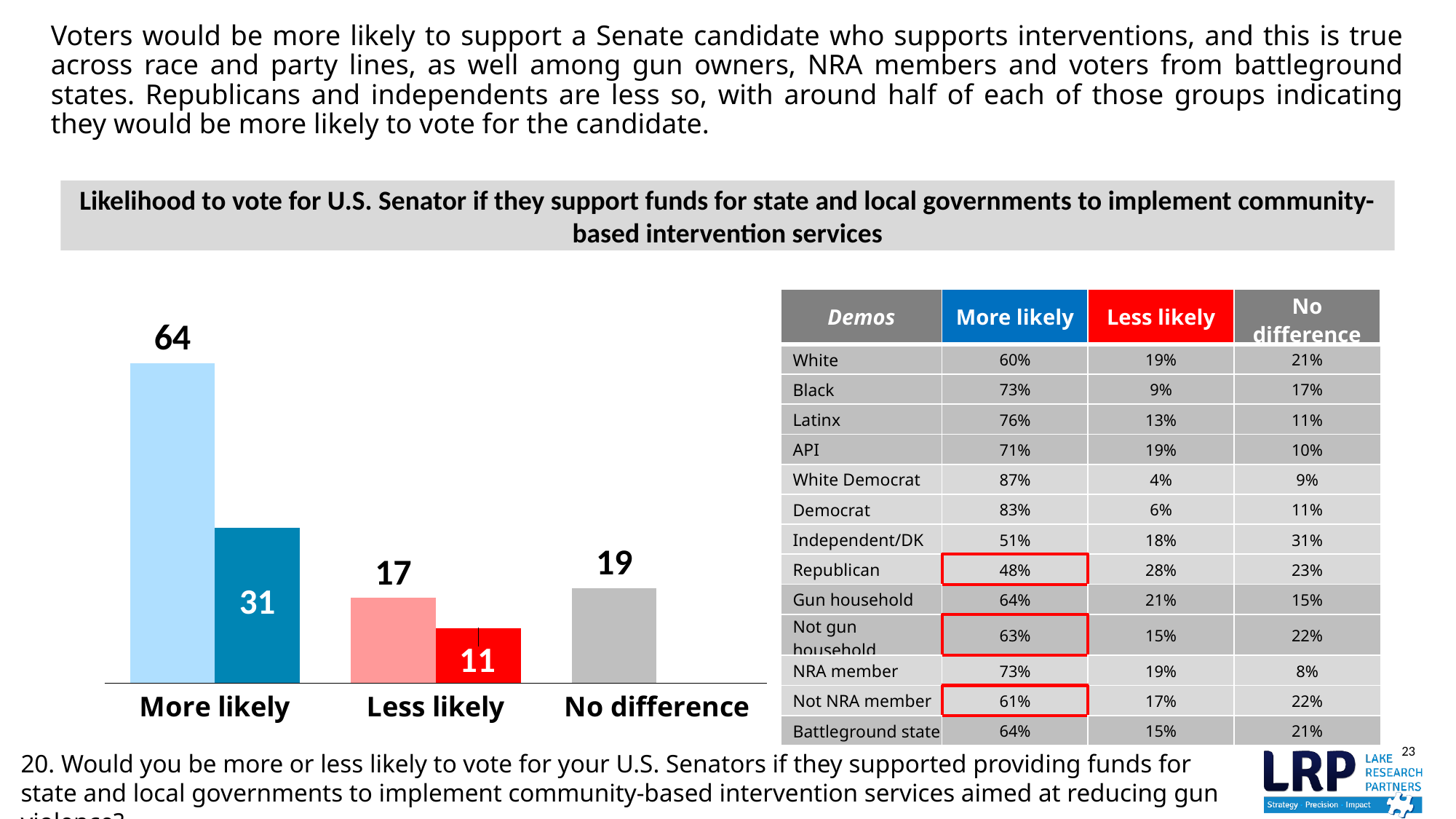
How many categories are shown on the x axis of the bar chart? 3 Which of the three categories has the lowest labeled value among the light-coloured bars (64, 17, 19)? Less likely What is the value of the dark blue bar within the 'More likely' category? 31 Which is larger, the 'No difference' bar or the light pink 'Less likely' bar? No difference What kind of chart is shown on the slide? bar chart What is the title shown in the grey box above the chart? Likelihood to vote for U.S. Senator if they support funds for state and local governments to implement community-based intervention services What is the difference between the 'More likely' value (64) and the 'Less likely' value (17)? 47 What is the value of the bright red bar within the 'Less likely' category? 11 Which category has the highest bar in the chart? More likely What is the value of the tall light blue bar for 'More likely'? 64 What is the value of the light pink bar for 'Less likely'? 17 What is the value of the bar for 'No difference'? 19